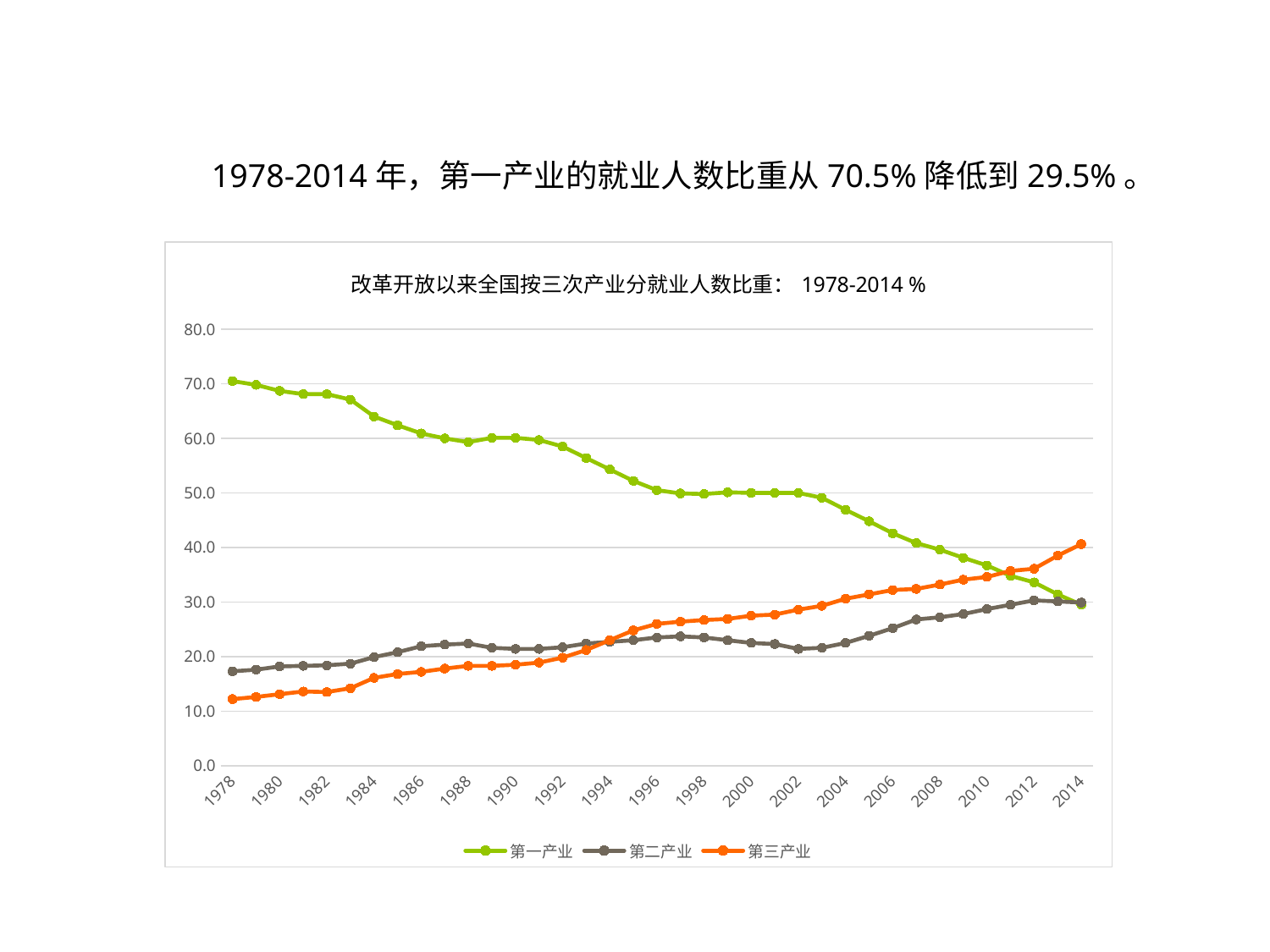
By how many percentage points did the 第一产业 share fall from 1978 to 2014? 41.0 What is the value for 第一产业 in 2014? 29.5% In 1990, which is larger: 第二产业 or 第三产业? 第二产业 Which series has the lowest value in 1978? 第三产业 What is the title of the chart? 改革开放以来全国按三次产业分就业人数比重： 1978-2014 % What kind of chart is shown on the slide? line chart Is the value for 第二产业 in 1978 greater or less than 20.0? less Does the 第三产业 line rise or fall from 1978 to 2014? rise Which series has the highest value in 1978? 第一产业 Which series has the highest value in 2014? 第三产业 What is the value for 第一产业 in 1978? 70.5% How many series does the chart legend list? 3